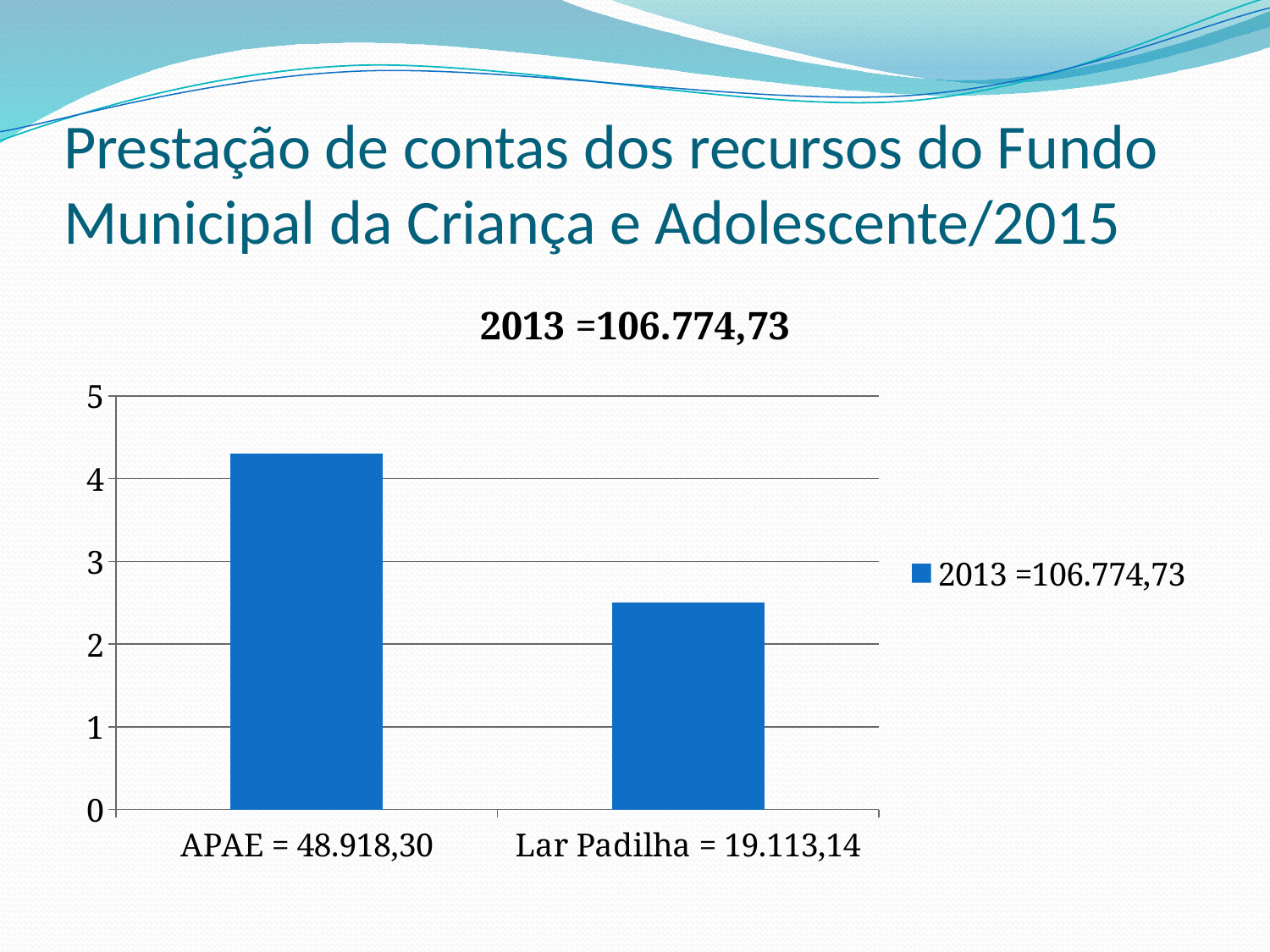
What kind of chart is shown on the slide? bar chart Do the bars rise or fall from left to right along the x axis? fall How many series does the legend list? 1 Is the bar for Lar Padilha greater or less than 3? less Is the bar for Lar Padilha greater or less than 2? greater What is the title of the chart? 2013 =106.774,73 Which category has the shortest bar? Lar Padilha = 19.113,14 What is the legend entry shown on the chart? 2013 =106.774,73 How many bars does the chart have? 2 Which bar is taller, APAE or Lar Padilha? APAE Which category has the tallest bar? APAE = 48.918,30 Is the bar for APAE greater or less than 4? greater